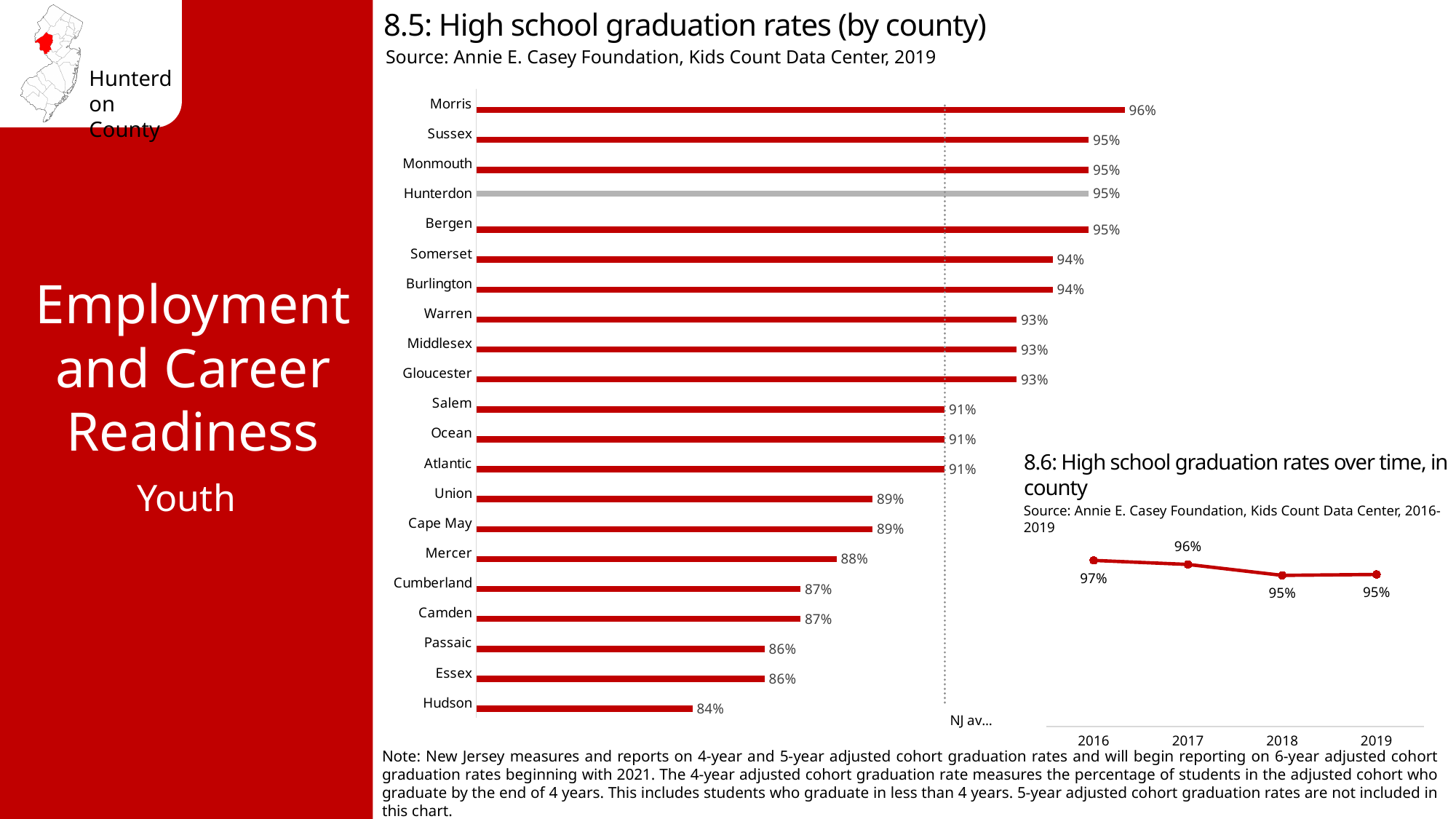
What kind of chart is chart 8.5 (High school graduation rates by county)? Bar chart In chart 8.6 (High school graduation rates over time, in county), what is the graduation rate for 2019? 95% In chart 8.5 (High school graduation rates by county), which county has the lowest graduation rate? Hudson In chart 8.5 (High school graduation rates by county), what is the graduation rate for Hunterdon? 95% In chart 8.5 (High school graduation rates by county), which county has a higher graduation rate, Mercer or Somerset? Somerset In chart 8.6 (High school graduation rates over time, in county), what is the graduation rate for 2016? 97% In chart 8.5 (High school graduation rates by county), how many counties are shown? 21 In chart 8.6 (High school graduation rates over time, in county), do the values rise or fall from 2016 to 2019? Fall In chart 8.5 (High school graduation rates by county), which county has the highest graduation rate? Morris In chart 8.5 (High school graduation rates by county), what is the difference between the graduation rates of Morris and Hudson? 12% In chart 8.5 (High school graduation rates by county), what is the graduation rate for Hudson? 84% In chart 8.5 (High school graduation rates by county), which county's bar is shown in grey rather than red? Hunterdon